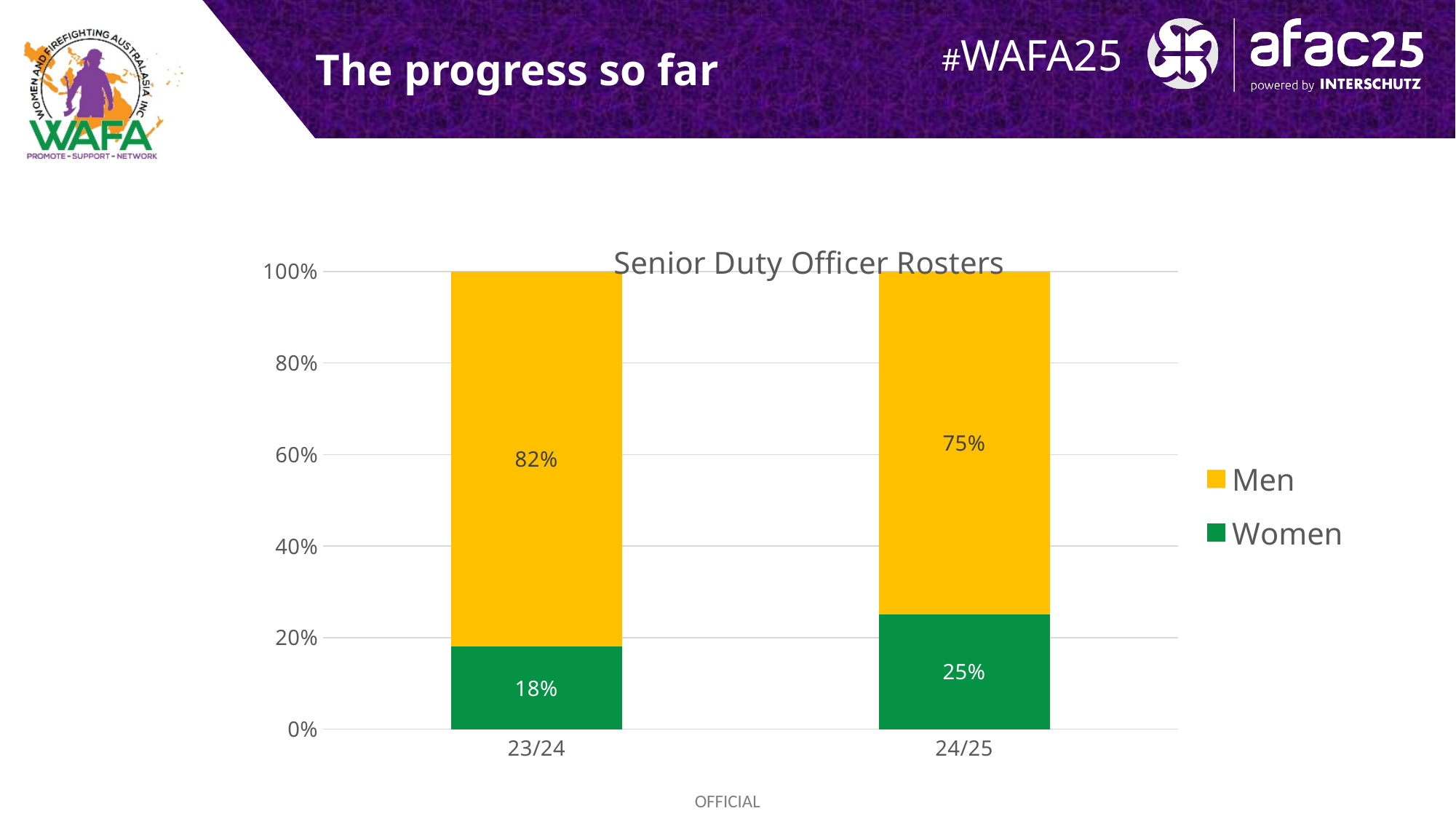
What is the value for Women in 23/24? 18% What is the value for Women in 24/25? 25% What is the title of the chart? Senior Duty Officer Rosters What is the value for Men in 24/25? 75% How many series does the legend list? 2 What is the value for Men in 23/24? 82% How many categories are shown on the x axis? 2 What is the difference between the Women values for 24/25 and 23/24? 7% Which year has the higher value for Women? 24/25 What kind of chart is shown? Stacked bar chart Is the value for Men in 23/24 larger than the value for Men in 24/25? Yes Which year has the lower value for Men? 24/25